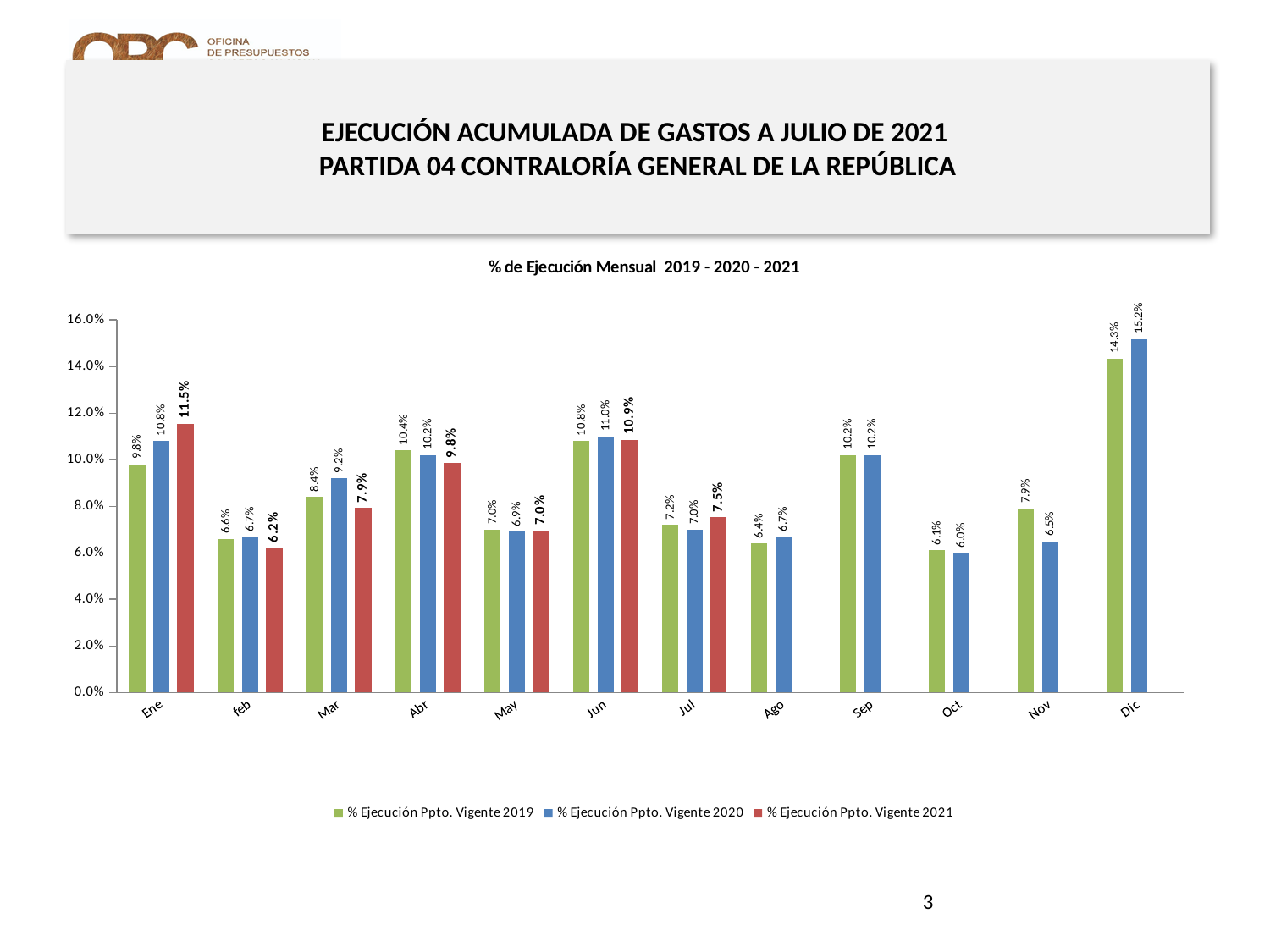
What is the value for Dic in the % Ejecución Ppto. Vigente 2020 series? 15.2% How many series does the legend list? 3 What is the value for Sep in the % Ejecución Ppto. Vigente 2019 series? 10.2% Is the value for Oct in the % Ejecución Ppto. Vigente 2019 series greater or less than 8.0%? less What kind of chart is shown on the slide? Bar chart Which month has the lowest value in the % Ejecución Ppto. Vigente 2021 series? feb What is the difference between the 2020 and 2019 values for Dic? 0.9% What is the title of the chart? % de Ejecución Mensual 2019 - 2020 - 2021 What is the value for Ene in the % Ejecución Ppto. Vigente 2021 series? 11.5% Which month has the highest value in the % Ejecución Ppto. Vigente 2019 series? Dic How many months are shown on the x axis? 12 Which is larger for Mar: the % Ejecución Ppto. Vigente 2020 value or the % Ejecución Ppto. Vigente 2021 value? % Ejecución Ppto. Vigente 2020